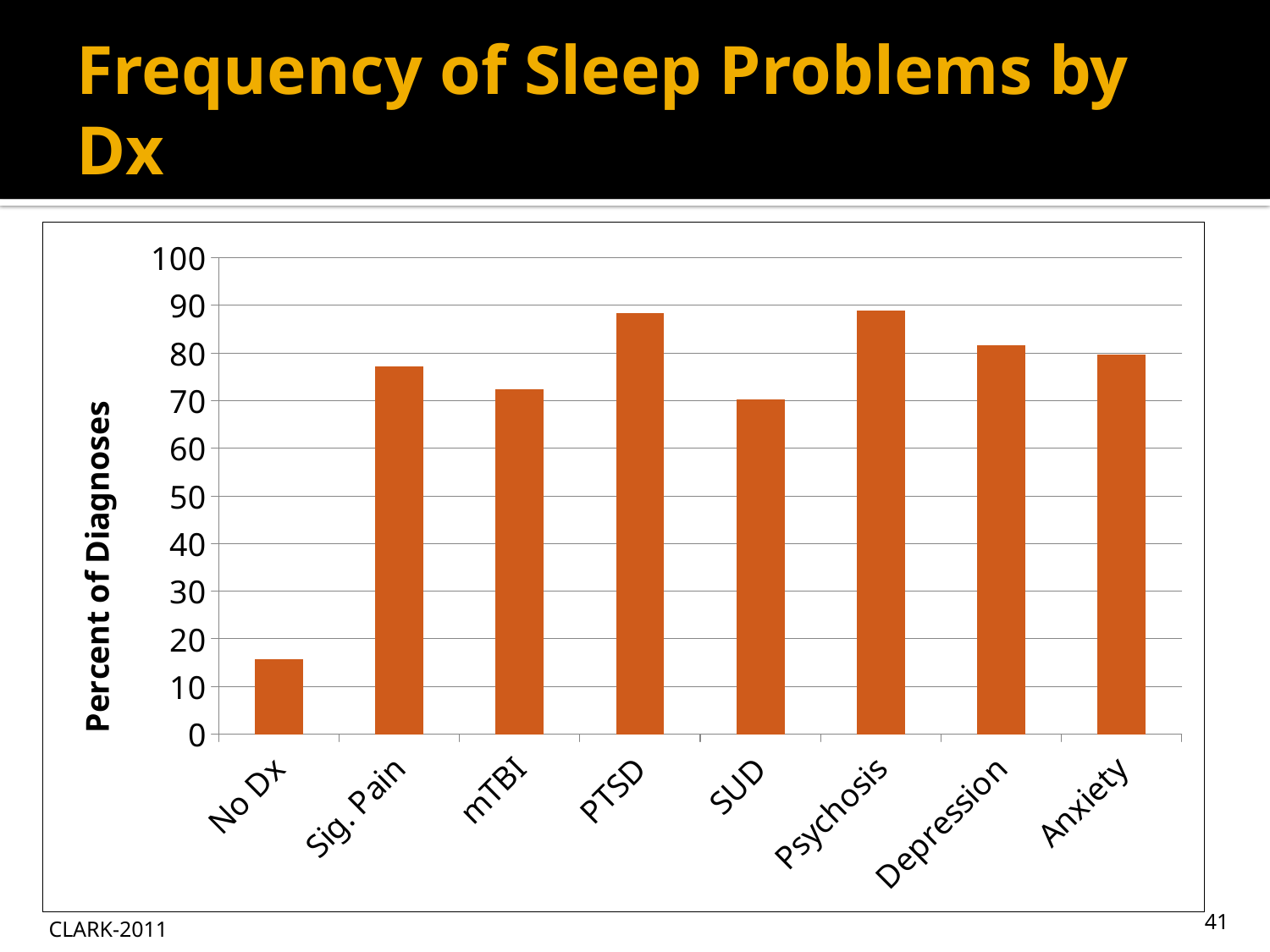
Which category has the lowest percent of diagnoses? No Dx Which is larger, the value for Depression or the value for mTBI? Depression Is the value for No Dx greater or less than 20? less Is the value for SUD greater or less than 80? less Is the value for mTBI greater or less than 70? greater What is the label on the vertical axis of the chart? Percent of Diagnoses What kind of chart is shown on the slide? bar chart Which is larger, the value for No Dx or the value for Anxiety? Anxiety How many diagnosis categories are shown on the x axis? 8 Which is larger, the value for PTSD or the value for SUD? PTSD